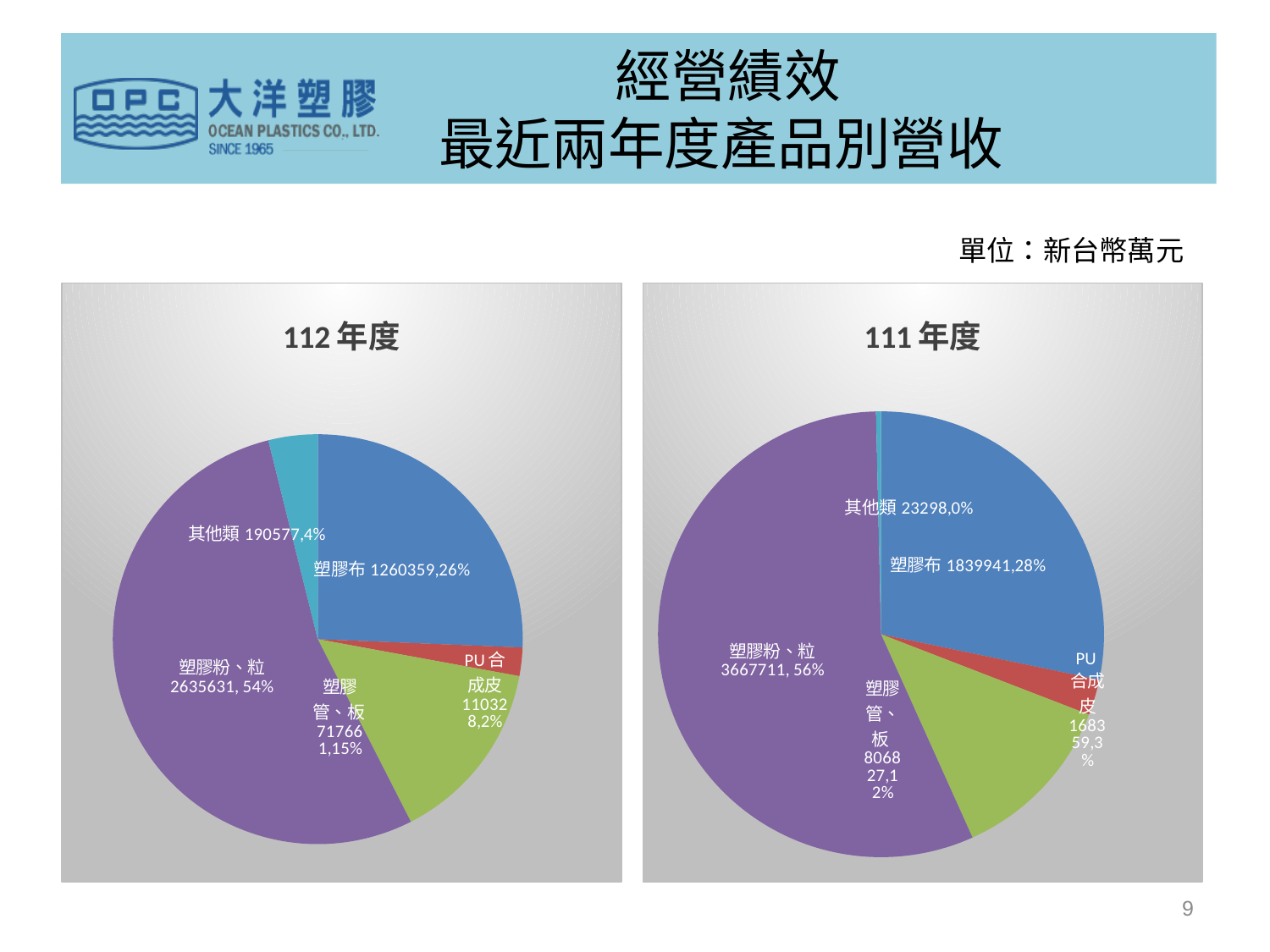
Is the value for 塑膠布 larger in the 112 年度 chart or the 111 年度 chart? 111 年度 In the 112 年度 chart, how many slices does the pie have? 5 In the 112 年度 chart, what is the value for 塑膠布? 1260359 In the 112 年度 chart, what share of the pie is 塑膠布? 26% In the 111 年度 chart, which category has the smallest slice? 其他類 What unit is stated for the values on the slide? 新台幣萬元 In the 112 年度 chart, which category has the largest slice? 塑膠粉、粒 In the 112 年度 chart, what is the value for 其他類? 190577 What is the difference between the 塑膠布 value in the 111 年度 chart and the 塑膠布 value in the 112 年度 chart? 579582 What kind of charts are shown on the slide? Pie charts In the 111 年度 chart, what is the value for 塑膠粉、粒? 3667711 In the 111 年度 chart, what share of the pie is 塑膠粉、粒? 56%